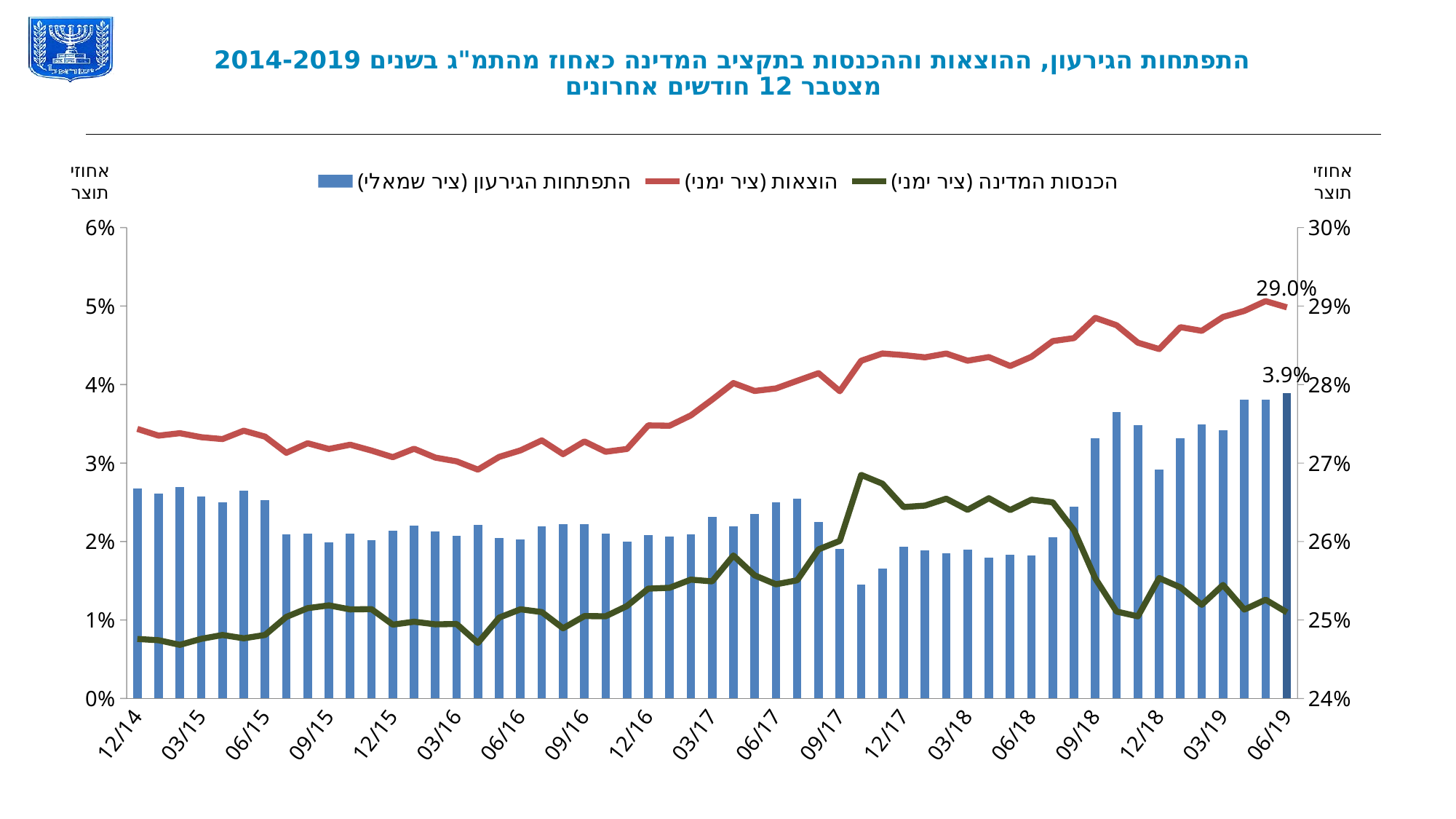
What colour is the expenditures (הוצאות) line? Red Does the expenditures (הוצאות) line rise or fall overall from 12/14 to 06/19? rise Is the revenues (הכנסות המדינה) value at 12/14 greater or less than 25%? less Is the deficit bar for 12/18 greater or less than 3%? less What is the labelled value of the expenditures (הוצאות) line at 06/19? 29.0% Which series is plotted on the left axis according to the legend? התפתחות הגירעון (the deficit) Is the deficit bar for 12/14 greater or less than 2%? greater At 06/19, which is larger: the expenditures (הוצאות) value or the revenues (הכנסות המדינה) value? Expenditures (הוצאות) How many series does the legend list? 3 What is the labelled value of the deficit (התפתחות הגירעון) bar at 06/19? 3.9% What kind of chart is shown on the slide? A combined bar and line chart